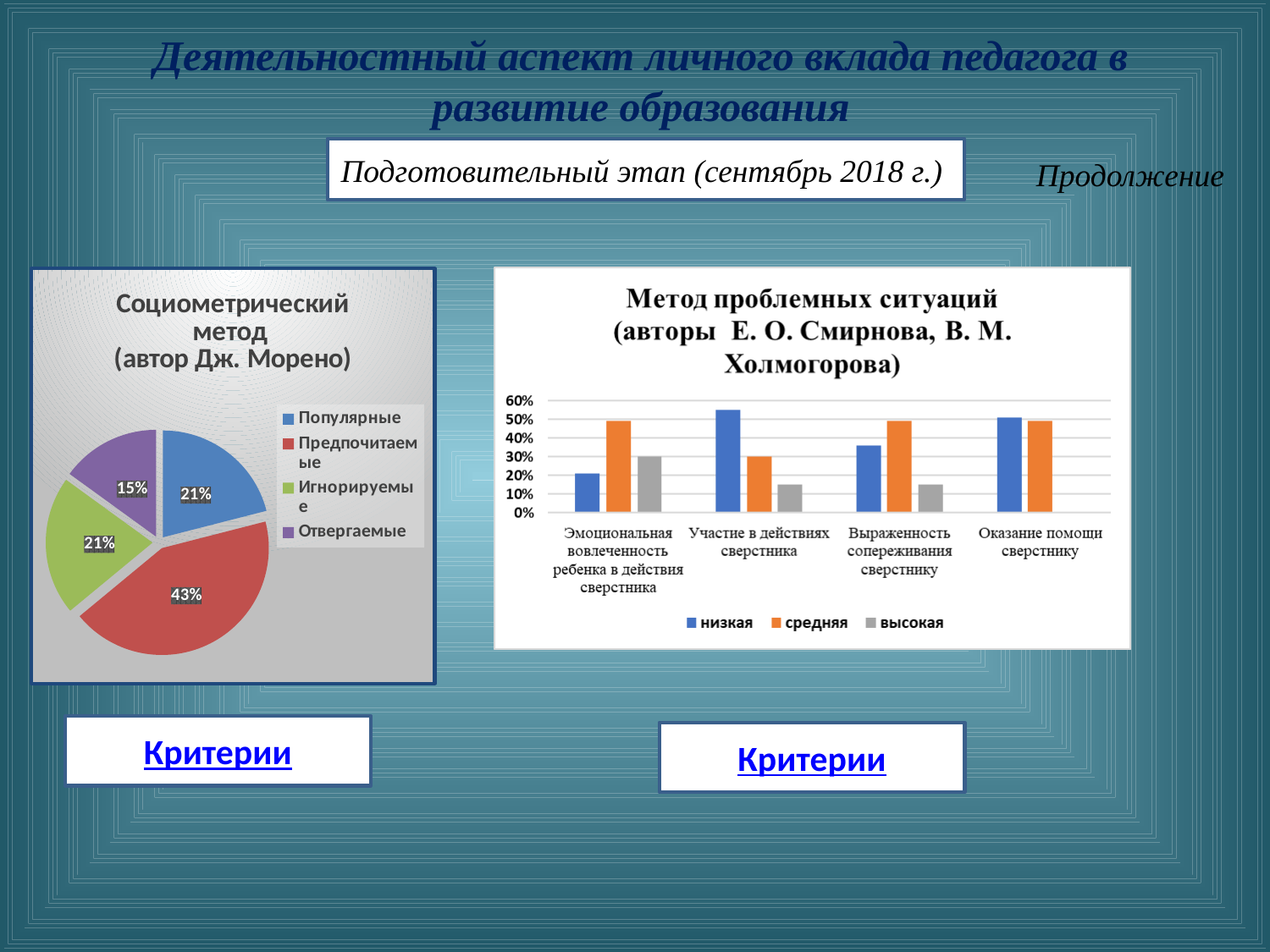
How many series does the legend of the chart 'Метод проблемных ситуаций' list? 3 In the pie chart 'Социометрический метод (автор Дж. Морено)', what share is labelled for Отвергаемые? 15% In the chart 'Метод проблемных ситуаций', which series is shown in orange? средняя In the pie chart 'Социометрический метод (автор Дж. Морено)', what is the difference between the shares of Предпочитаемые and Популярные? 22% In the pie chart 'Социометрический метод (автор Дж. Морено)', which category has the largest share? Предпочитаемые In the pie chart 'Социометрический метод (автор Дж. Морено)', which category has the smallest share? Отвергаемые In the chart 'Метод проблемных ситуаций', is the value of высокая for 'Выраженность сопереживания сверстнику' greater or less than 20%? less In the chart 'Метод проблемных ситуаций', is the value of низкая for 'Участие в действиях сверстника' greater or less than 50%? greater In the pie chart 'Социометрический метод (автор Дж. Морено)', what share is labelled for Предпочитаемые? 43% How many categories does the pie chart 'Социометрический метод (автор Дж. Морено)' show? 4 In the chart 'Метод проблемных ситуаций', for 'Эмоциональная вовлеченность ребенка в действия сверстника', which is larger: низкая or средняя? средняя What kind of chart is the chart titled 'Метод проблемных ситуаций'? bar chart